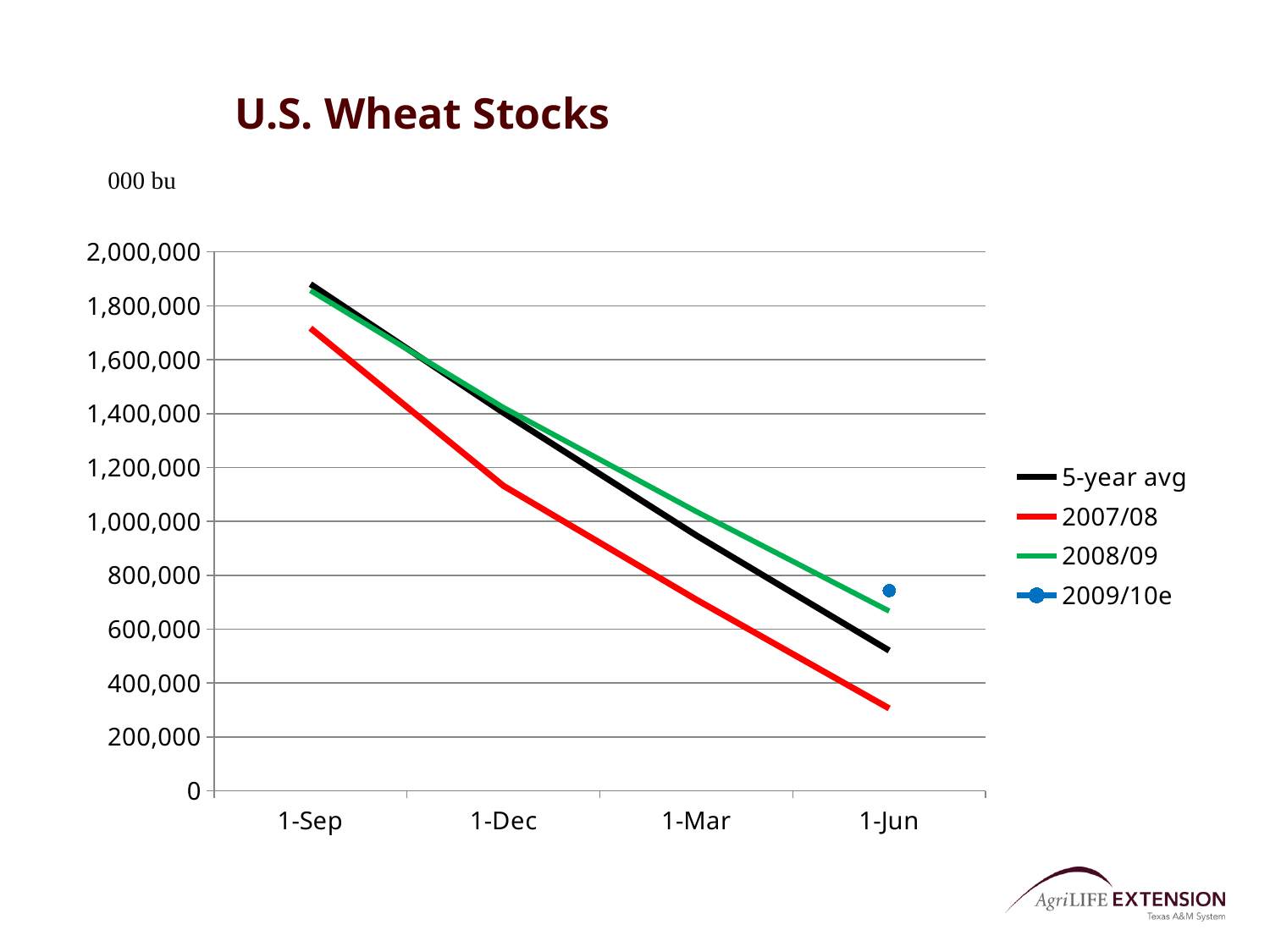
At 1-Jun, which series has the lowest value? 2007/08 Is the value for 2007/08 at 1-Jun greater or less than 400,000? less How many dates are shown on the x axis? 4 Do the values for the 2007/08 series rise or fall from 1-Sep to 1-Jun? fall Is the value for 2007/08 at 1-Sep greater or less than 1,800,000? less Is the value for 2008/09 at 1-Jun greater or less than 600,000? greater What kind of chart is shown on the slide? line chart At 1-Jun, which is larger: the value for 2008/09 or the value for 2007/08? 2008/09 What unit label is shown above the y axis? 000 bu At 1-Jun, which is larger: the value for 2009/10e or the value for the 5-year avg? 2009/10e How many series does the legend list? 4